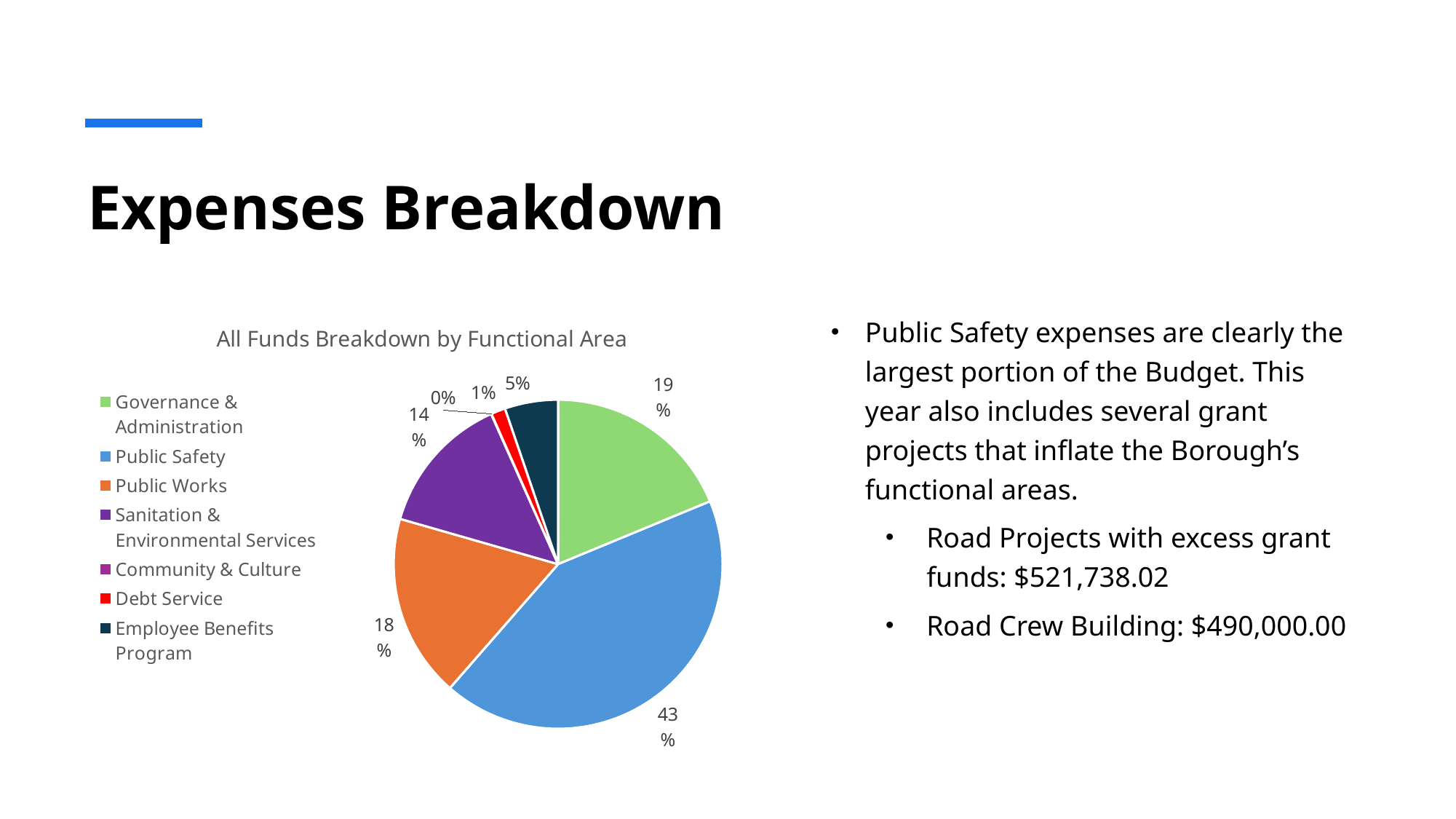
Which functional area has the smallest share of the pie? Community & Culture What is the chart's title? All Funds Breakdown by Functional Area What type of chart is shown on the slide? pie chart What share of the pie does Governance & Administration represent? 19% What share of the pie does Public Works represent? 18% Which functional area has the largest share of the pie? Public Safety What share of the pie does Employee Benefits Program represent? 5% How many functional areas does the legend list? 7 What is the difference in percentage points between Public Safety and Governance & Administration? 24